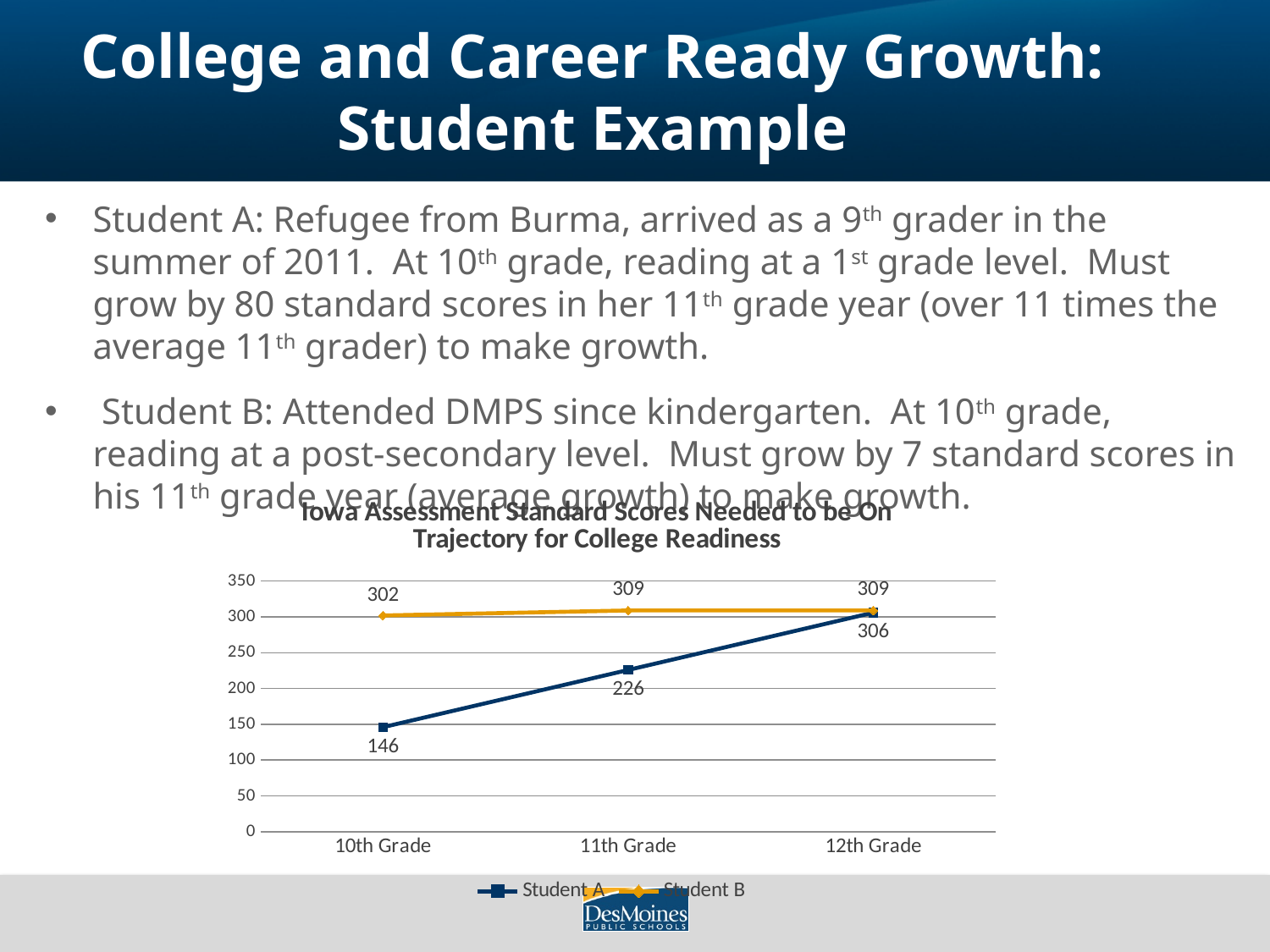
What is the value for Student B in 11th Grade? 309 What is the value for Student B in 10th Grade? 302 In which grade is Student A's value lowest? 10th Grade Which is larger in 11th Grade, the value for Student A or for Student B? Student B How many grade levels are shown on the x axis? 3 What is the difference between Student B's and Student A's values in 10th Grade? 156 Is the value for Student A in 11th Grade greater or less than 200? greater How many series does the legend list? 2 What is the value for Student A in 10th Grade? 146 What kind of chart is shown on the slide? Line chart By how much does Student A's value increase from 10th Grade to 11th Grade? 80 What is the value for Student A in 12th Grade? 306